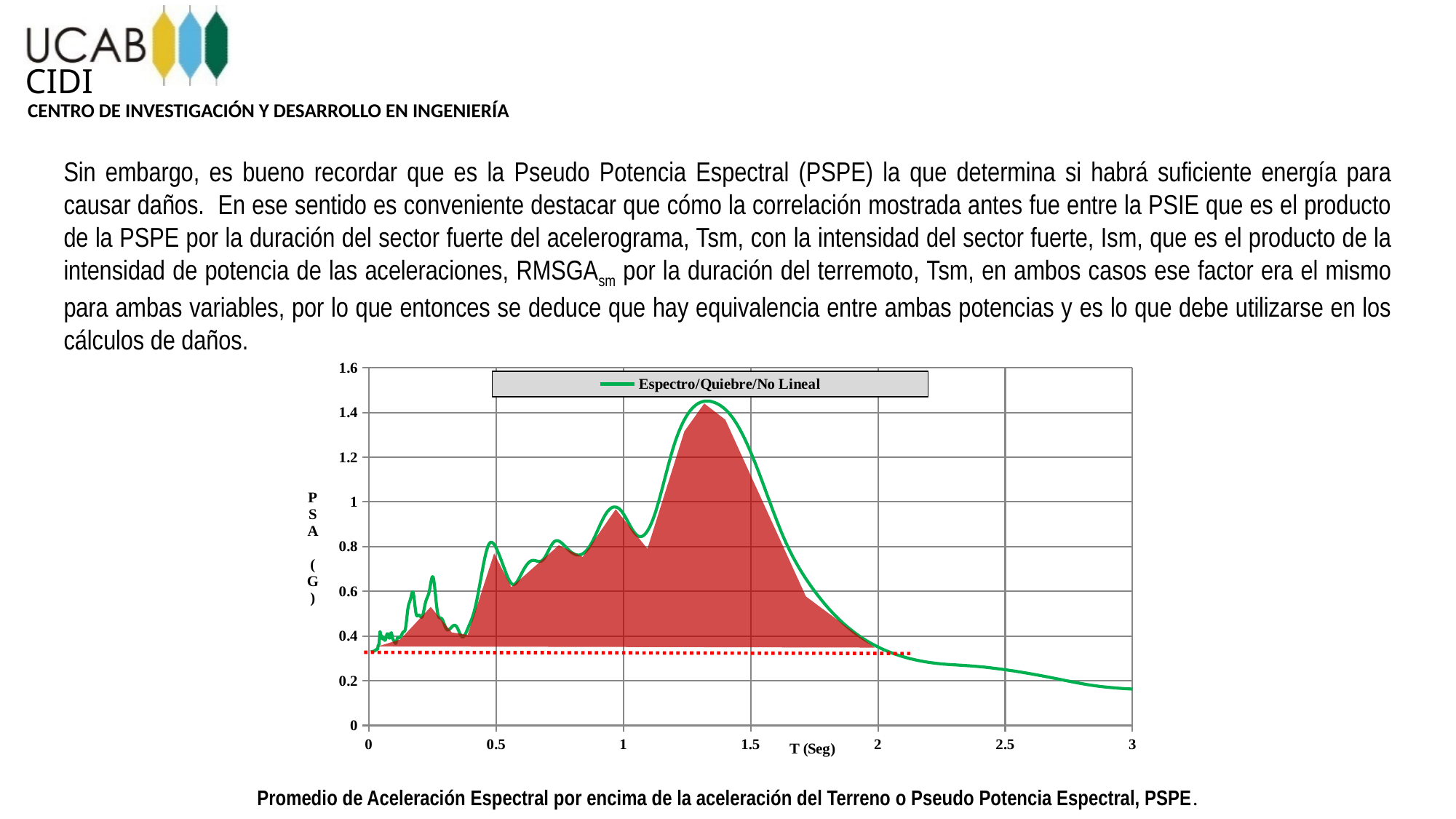
What kind of chart is shown on the slide? line chart Is the value of the green curve at T = 0.5 greater or less than 0.6? greater Is the level of the dotted red horizontal line greater or less than 0.4? less What is the name of the series shown in the chart legend? Espectro/Quiebre/No Lineal Does the green curve reach its maximum between T = 1 and T = 1.5? yes Is the value of the green curve at T = 2 greater or less than 0.4? less Between T = 1.5 and T = 3, does the green curve rise or fall? fall What is the label of the x axis of the chart? T (Seg) How many series does the chart legend list? 1